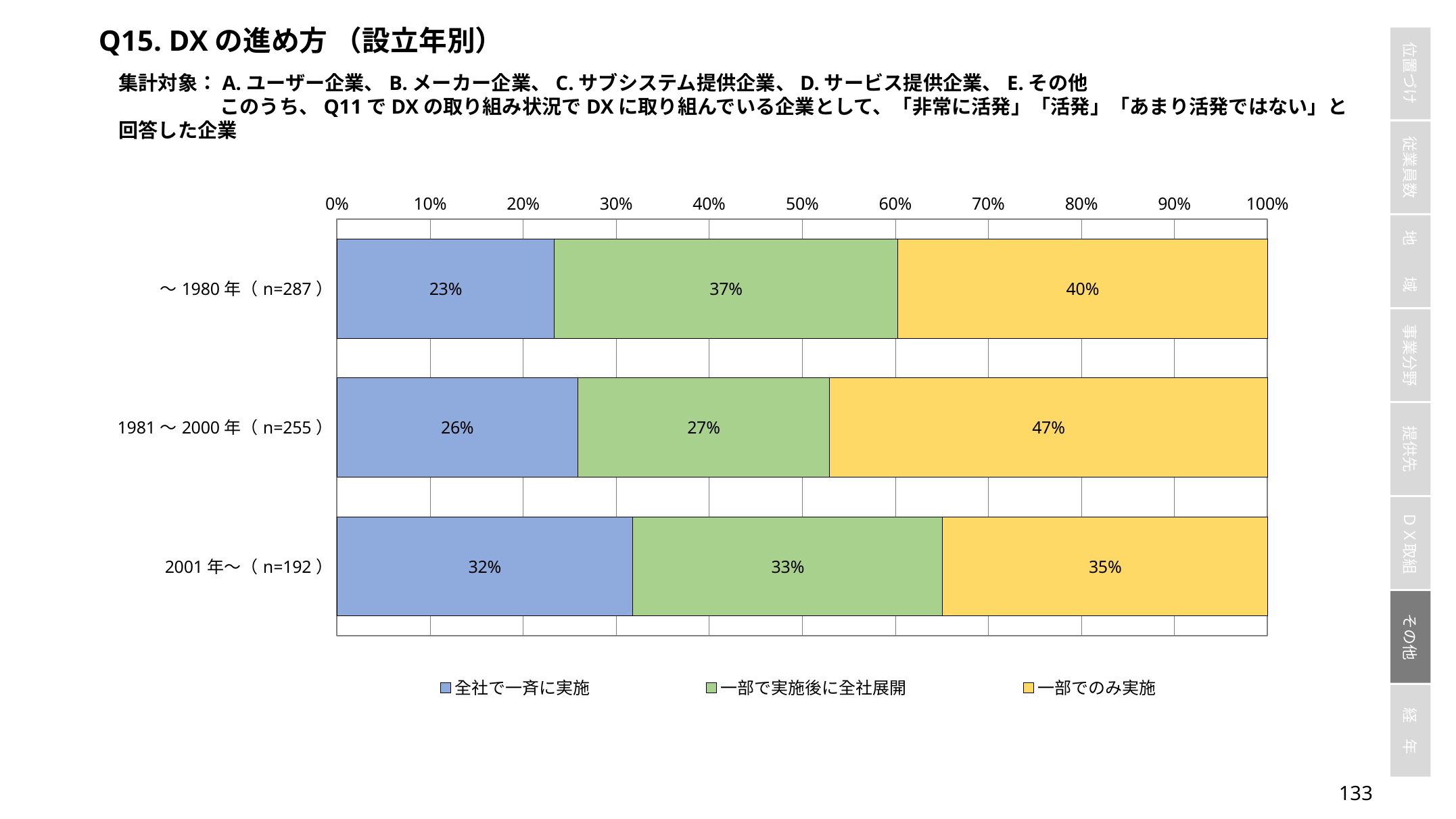
Which category has the lowest value for 全社で一斉に実施? ～1980年（n=287） What is the value for 全社で一斉に実施 in the ～1980年（n=287） category? 23% How many series does the legend list? 3 Which is larger: 一部で実施後に全社展開 for ～1980年（n=287） or for 1981～2000年（n=255）? ～1980年（n=287） How many categories are shown on the chart? 3 What is the difference between the 一部でのみ実施 values for 1981～2000年（n=255） and 2001年～（n=192）? 12% Which category has the highest value for 一部でのみ実施? 1981～2000年（n=255） What is the total of the stacked bar for 2001年～（n=192）? 100% What kind of chart is shown on the slide? Stacked bar chart What colour represents 一部でのみ実施 in the chart? Yellow What is the value for 一部でのみ実施 in the 1981～2000年（n=255） category? 47% What is the value for 一部で実施後に全社展開 in the 2001年～（n=192） category? 33%